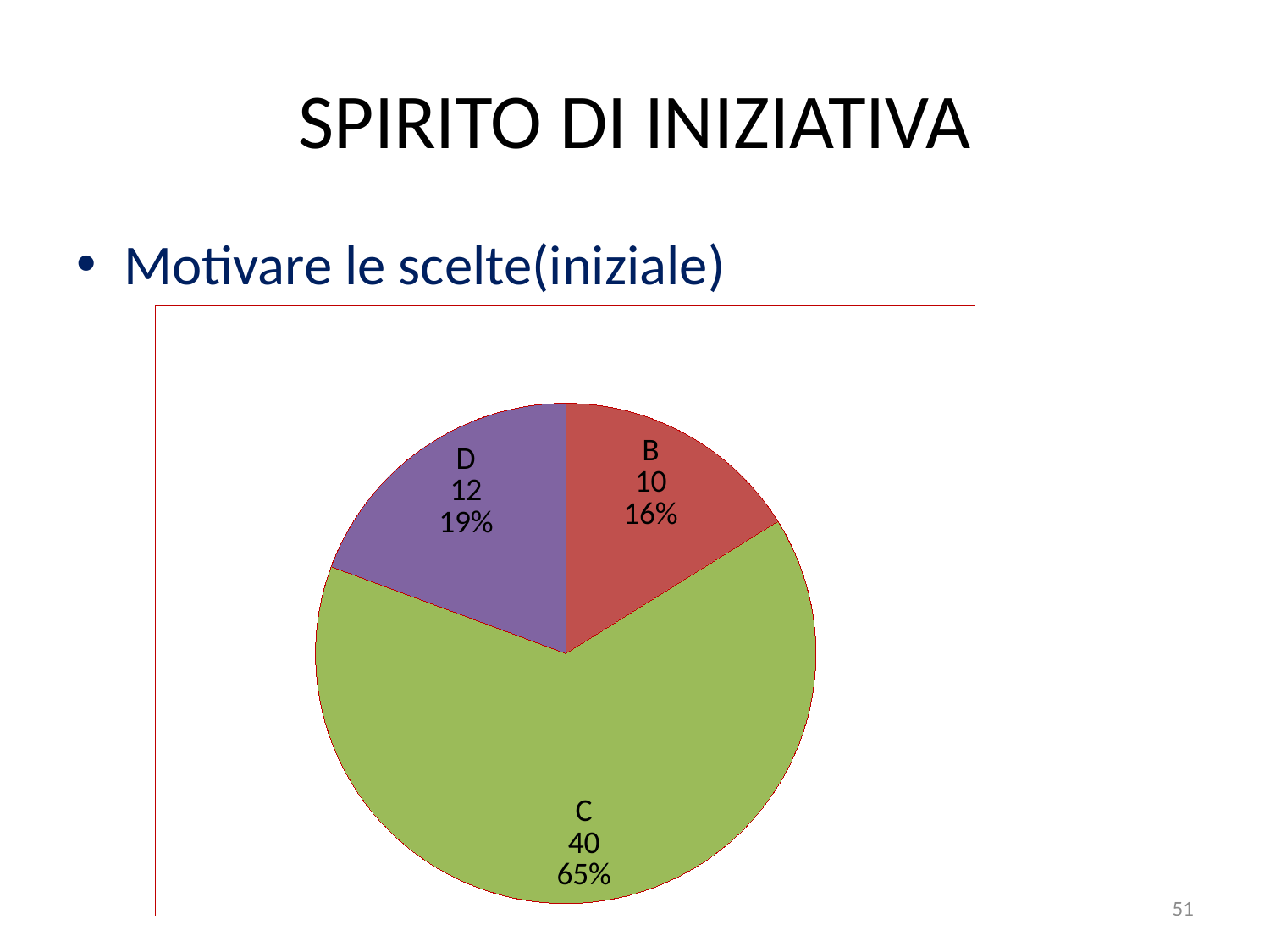
What is the difference between the values of C and D? 28 Which slice is the largest? C What percentage share does slice B have? 16% What is the value for slice D? 12 What is the value for slice B? 10 What kind of chart is shown on the slide? pie chart What percentage share does slice C have? 65% How many slices does the pie chart have? 3 What colour is slice C? green Which slice is the smallest? B What percentage share does slice D have? 19% What is the value for slice C? 40